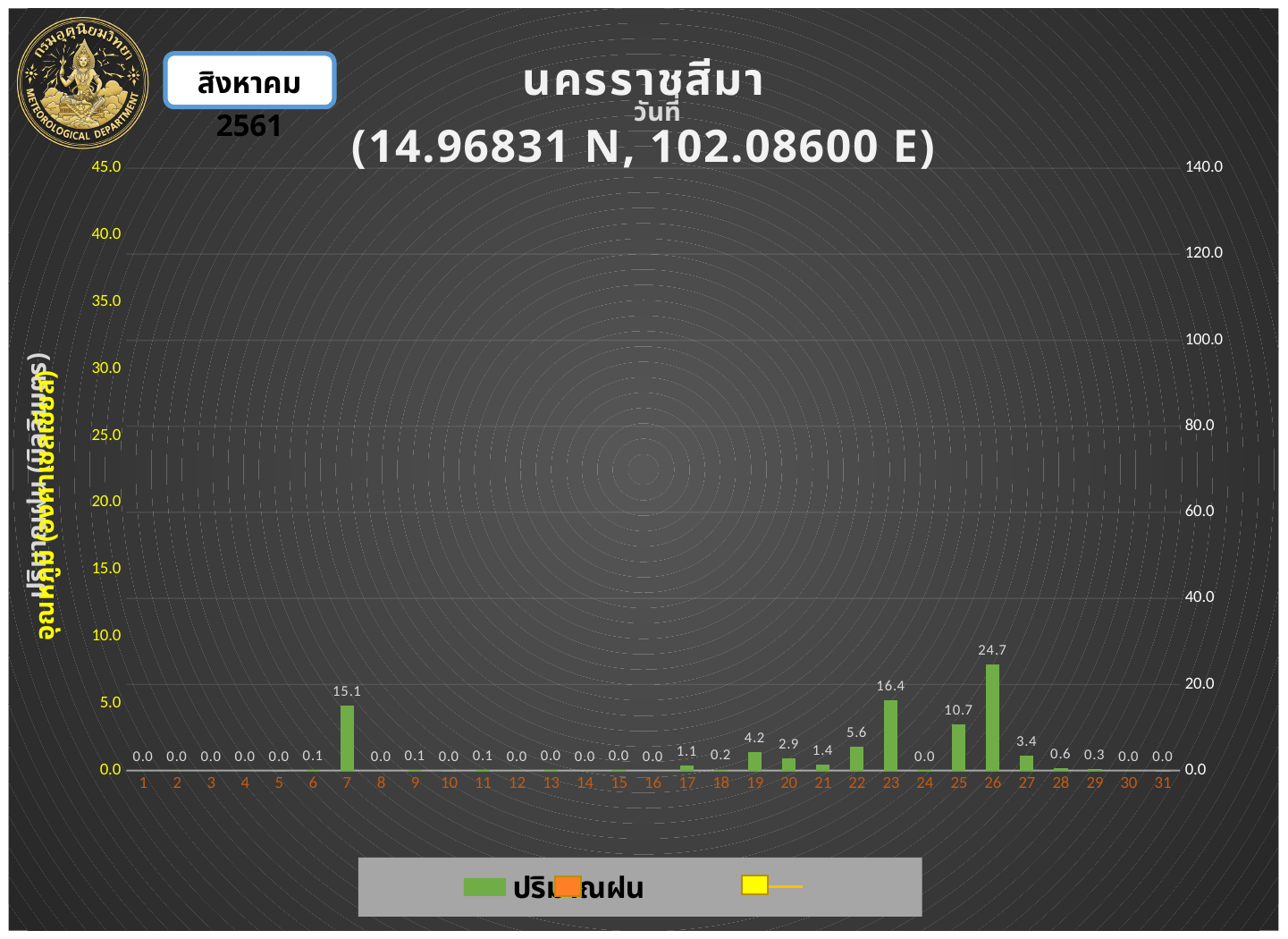
Which is larger, the value for day 19 or the value for day 20? day 19 What is the value for day 25? 10.7 What is the difference between the values for day 7 and day 25? 4.4 What is the value for day 7? 15.1 What is the difference between the values for day 26 and day 23? 8.3 What is the value for day 26? 24.7 How many days are shown on the x axis? 31 What is the value for day 23? 16.4 What is the value for day 22? 5.6 What coordinates are given in the chart title? 14.96831 N, 102.08600 E Which day has the highest value? 26 What kind of chart is this? bar chart